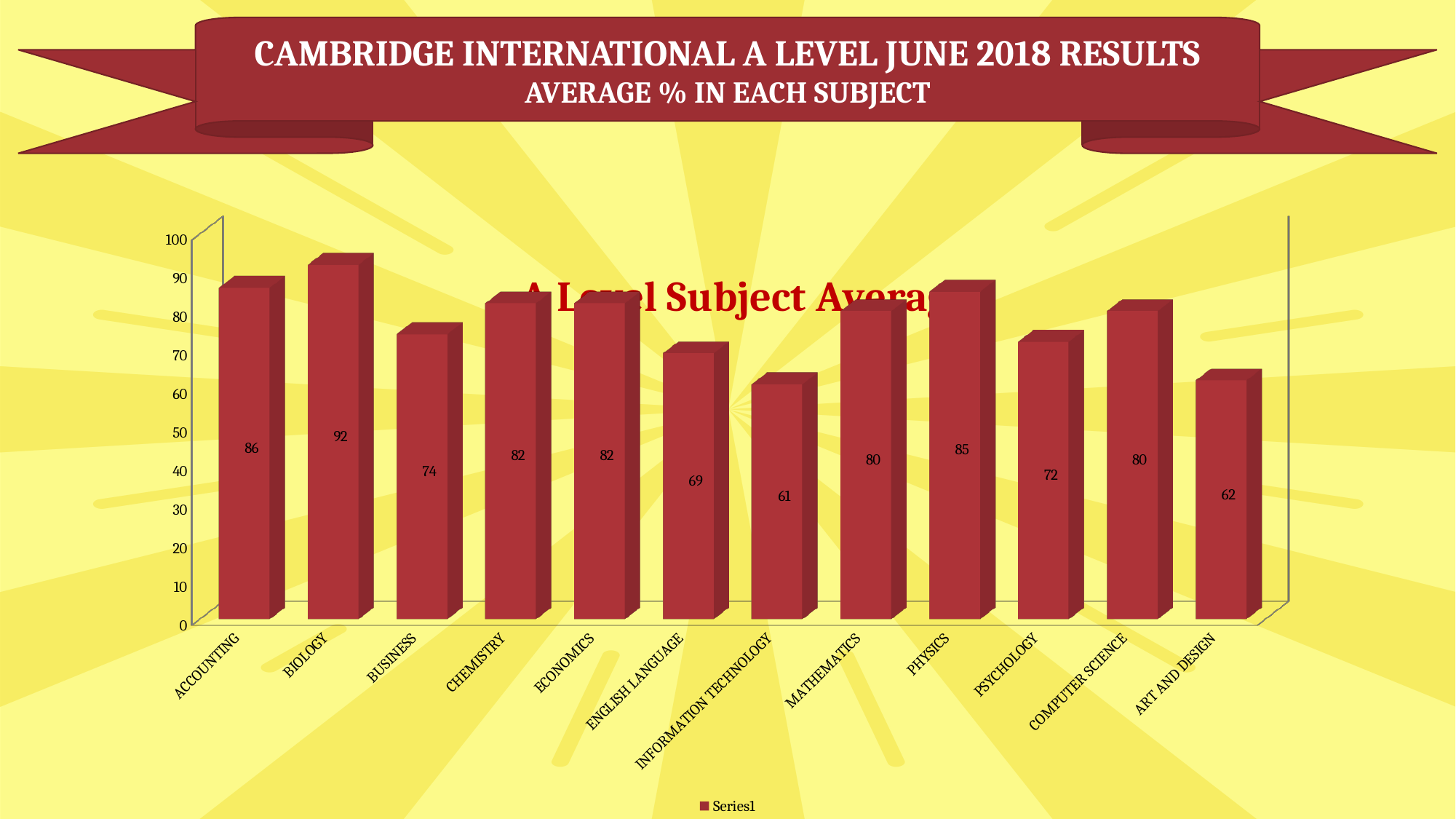
Is the value for Mathematics greater or less than 70? greater How many series does the legend list? 1 Which has a higher average %, Psychology or English Language? Psychology Which subject has the highest average %? Biology What is the average % for Information Technology? 61 How many subjects are shown on the chart? 12 What is the difference between the average % for Accounting and the average % for Business? 12 What kind of chart is shown on the slide? Bar chart What is the difference between the average % for Biology and the average % for Art and Design? 30 What is the average % for Physics? 85 What is the average % for Biology? 92 Which subject has the lowest average %? Information Technology